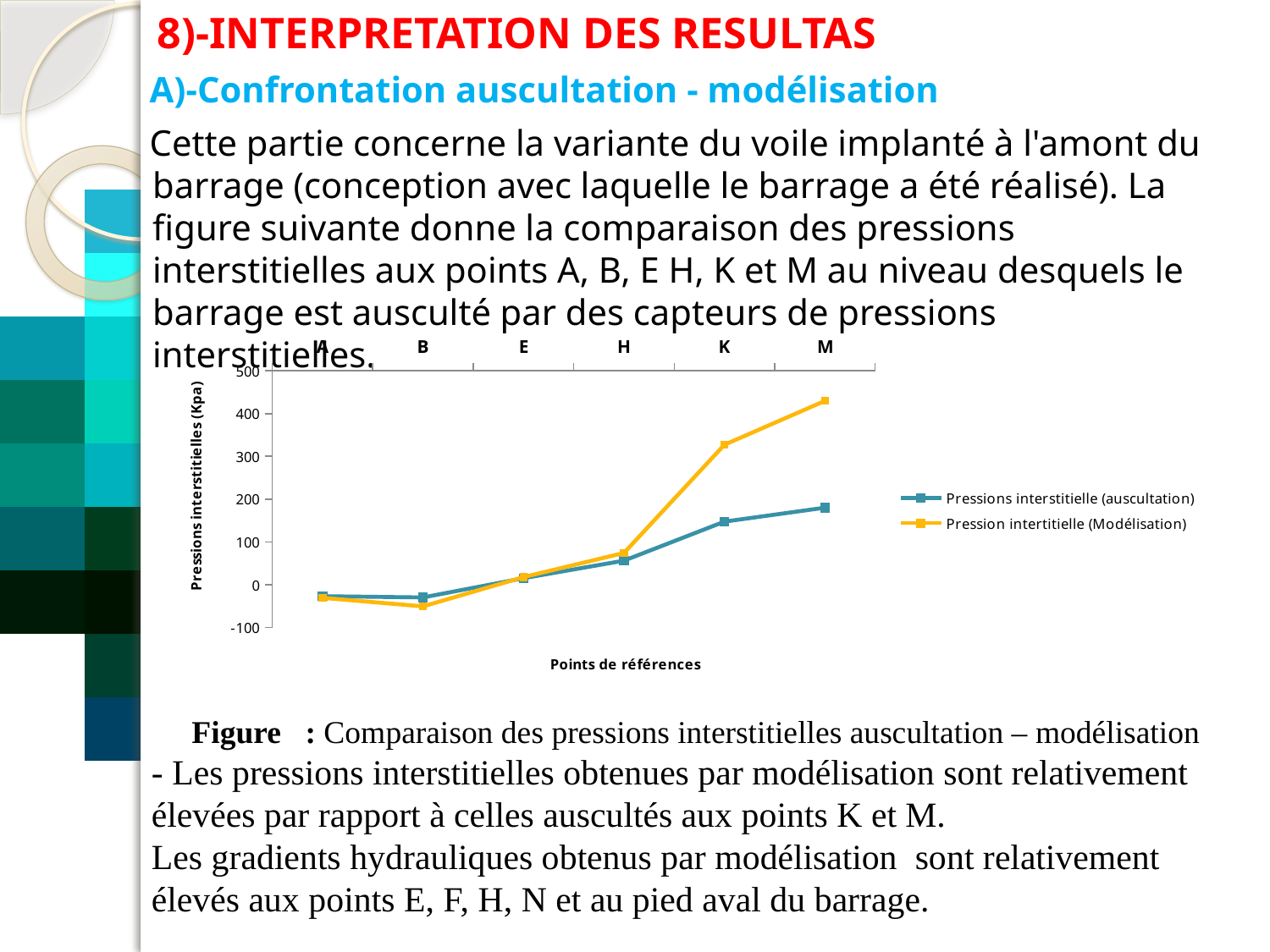
Is the value of 'Pression intertitielle (Modélisation)' at point K greater or less than 300? greater What is the title of the vertical axis of the chart? Pressions interstitielles (Kpa) What kind of chart is shown on the slide? line chart Does the 'Pressions interstitielle (auscultation)' series rise or fall from point H to point M? rise At point K, which series has the higher value: 'Pressions interstitielle (auscultation)' or 'Pression intertitielle (Modélisation)'? Pression intertitielle (Modélisation) Is the value of 'Pression intertitielle (Modélisation)' at point M greater or less than 400? greater At which reference point is the 'Pression intertitielle (Modélisation)' series highest? M At which reference point is the 'Pression intertitielle (Modélisation)' series lowest? B How many series does the chart legend list? 2 At which reference point is the 'Pressions interstitielle (auscultation)' series highest? M How many reference points are plotted along the x axis of the chart? 6 Is the value of 'Pressions interstitielle (auscultation)' at point M greater or less than 200? less